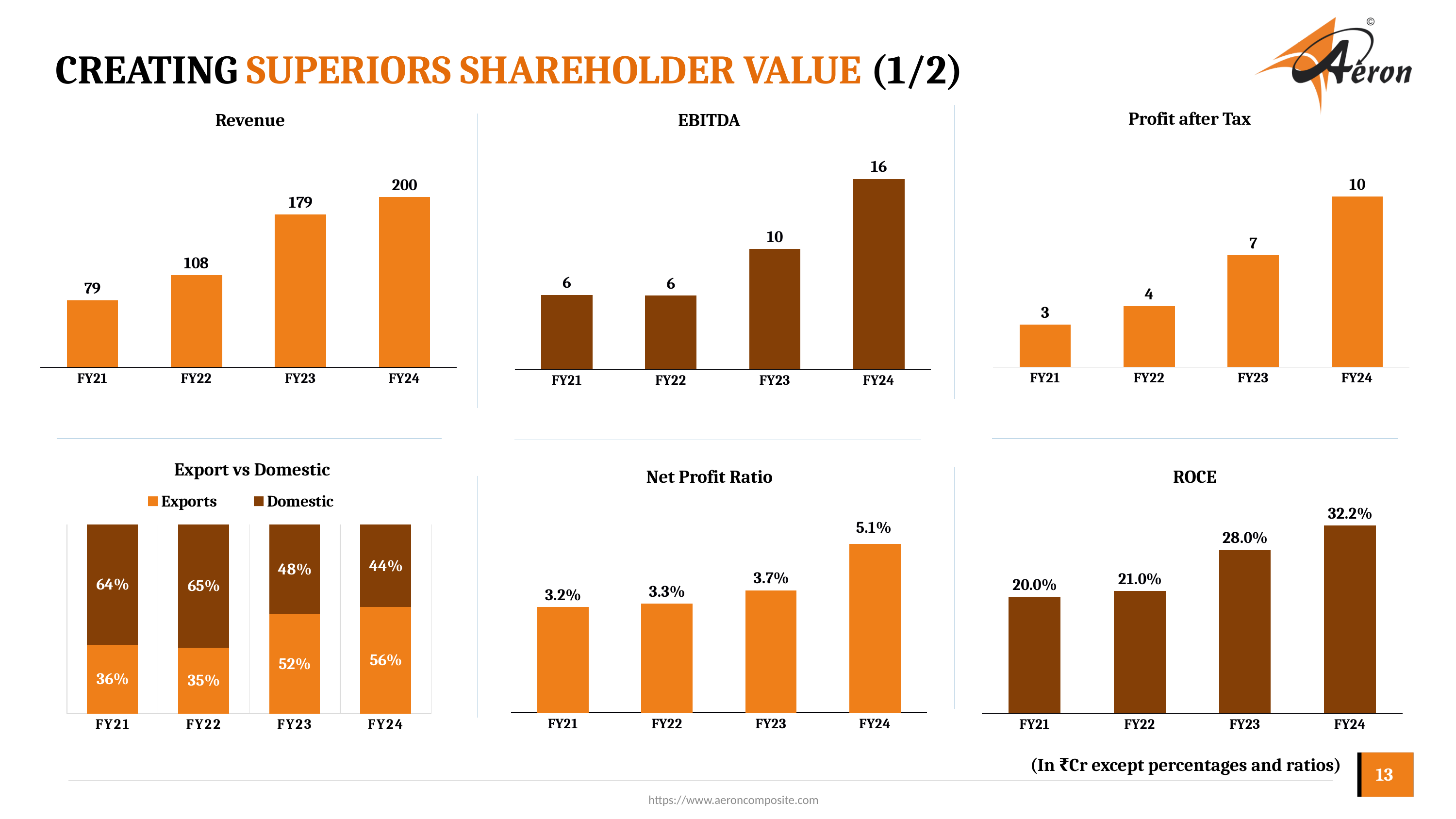
In the Profit after Tax chart, which year has the lowest value? FY21 In the Profit after Tax chart, what is the difference between FY24 and FY23? 3 In the Export vs Domestic chart, how many series does the legend list? 2 In the Revenue chart, what is the difference between FY24 and FY21? 121 In the Export vs Domestic chart, what is the Domestic share for FY22? 65% In the EBITDA chart, what is the value for FY22? 6 In the EBITDA chart, which year has the highest value? FY24 In the Net Profit Ratio chart, what is the value for FY24? 5.1% In the Export vs Domestic chart, what is the Exports share for FY23? 52% In the Revenue chart, what is the value for FY23? 179 In the ROCE chart, do the values rise or fall from FY21 to FY24? rise In the ROCE chart, which is larger, FY22 or FY23? FY23